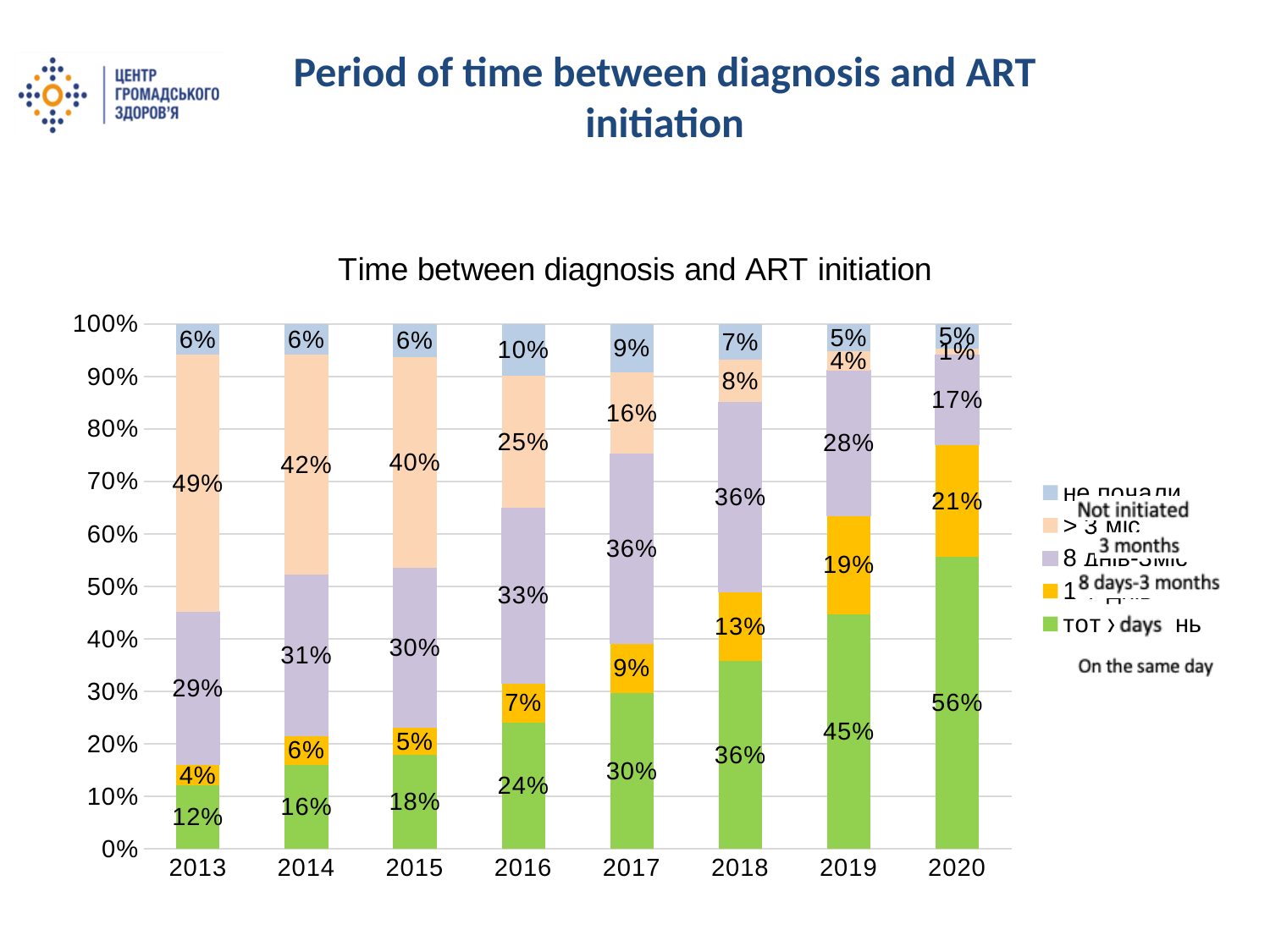
What is the title of the chart? Time between diagnosis and ART initiation By how many percentage points does the 'On the same day' share in 2020 exceed that in 2013? 44 percentage points What is the 'Not initiated' share for 2016? 10% In 2013, which is larger: the '> 3 months' segment or the '8 days-3 months' segment? > 3 months How many series does the legend list? 5 What is the '8 days-3 months' share for 2019? 28% Does the 'On the same day' share rise or fall from 2013 to 2020? rise How many years are shown on the x axis? 8 In which year is the 'On the same day' share the highest? 2020 In which year is the 'On the same day' share the lowest? 2013 What type of chart is shown? Stacked bar chart What percentage of the 2020 bar is 'On the same day'? 56%